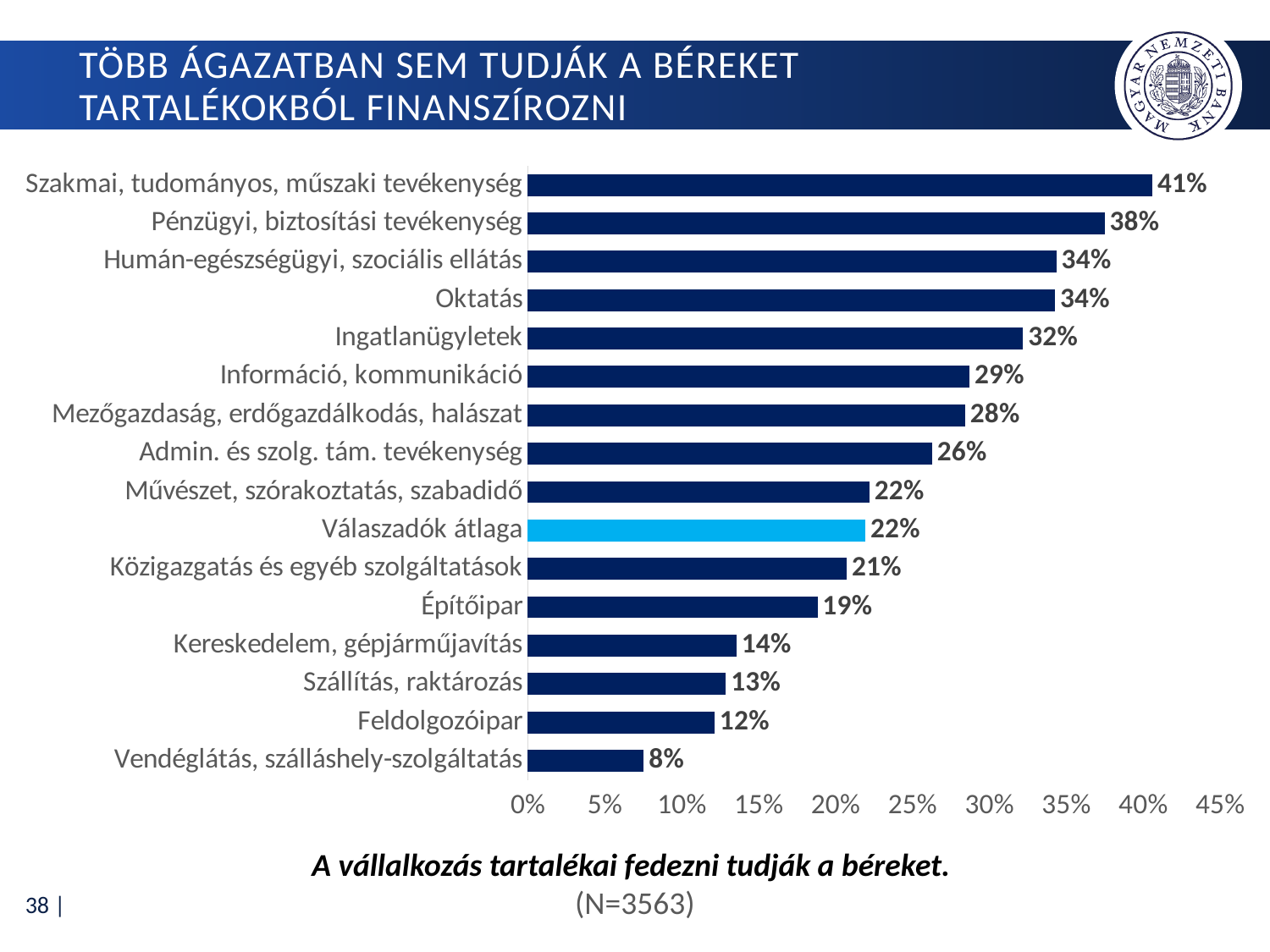
Which bar is shown in a different (light blue) colour from the others? Válaszadók átlaga What is the value for Feldolgozóipar? 12% What is the value for Szállítás, raktározás? 13% What is the value for Szakmai, tudományos, műszaki tevékenység? 41% What is the value for Válaszadók átlaga? 22% What is the difference between the values for Pénzügyi, biztosítási tevékenység and Építőipar? 19% Which category has the highest value? Szakmai, tudományos, műszaki tevékenység Which is larger, the value for Ingatlanügyletek or the value for Információ, kommunikáció? Ingatlanügyletek How many categories are shown in the chart? 16 Which category has the lowest value? Vendéglátás, szálláshely-szolgáltatás What kind of chart is shown on the slide? bar chart Is the value for Kereskedelem, gépjárműjavítás greater or less than 15%? less